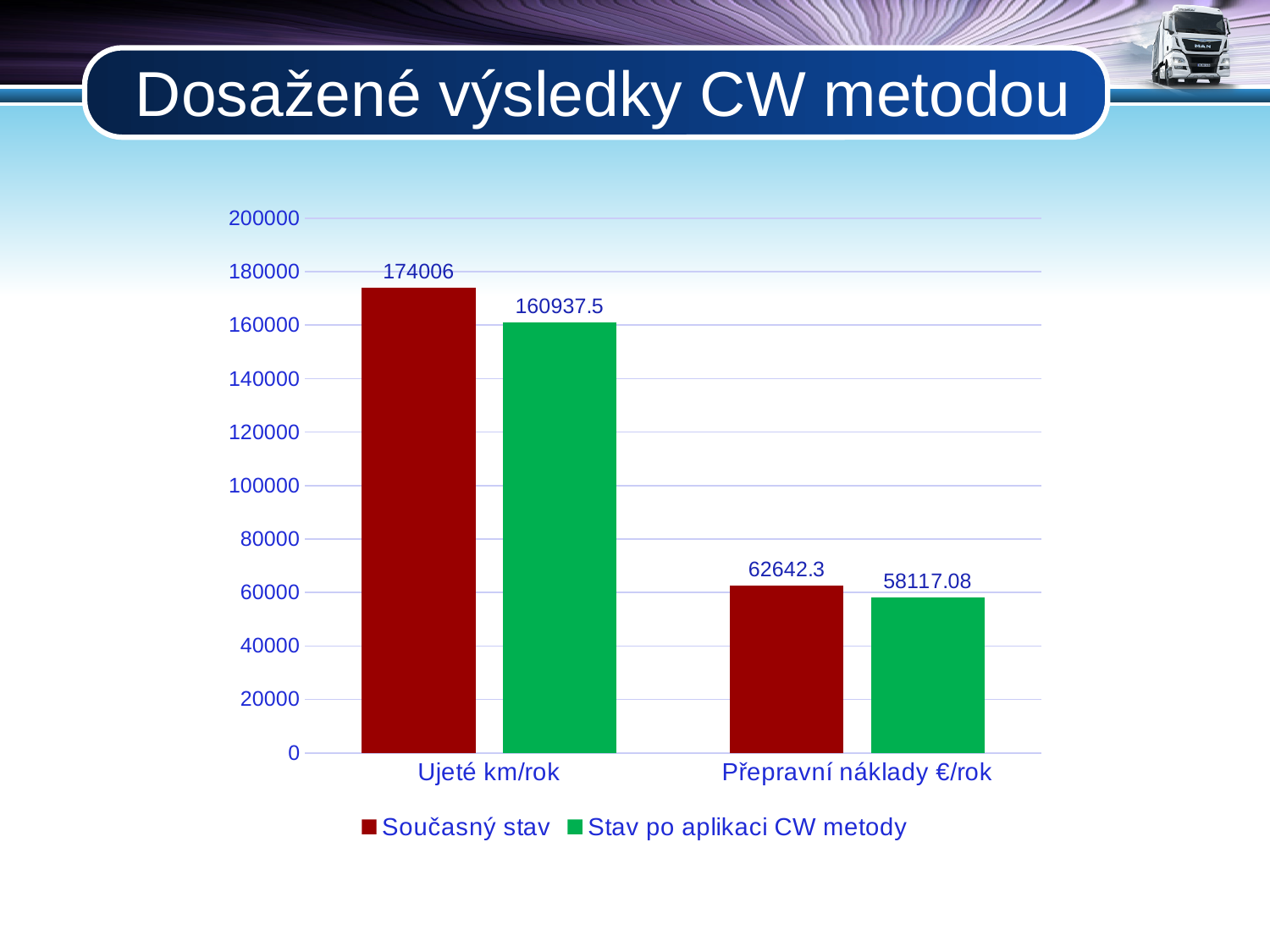
For Přepravní náklady €/rok, which is larger: Současný stav or Stav po aplikaci CW metody? Současný stav What is the difference between Současný stav and Stav po aplikaci CW metody for Ujeté km/rok? 13068.5 What is the difference between Současný stav and Stav po aplikaci CW metody for Přepravní náklady €/rok? 4525.22 What is the value of Současný stav for Přepravní náklady €/rok? 62642.3 What is the value of Současný stav for Ujeté km/rok? 174006 What is the value of Stav po aplikaci CW metody for Ujeté km/rok? 160937.5 What type of chart is shown on the slide? Bar chart What is the value of Stav po aplikaci CW metody for Přepravní náklady €/rok? 58117.08 Which bar has the highest value in the chart? Současný stav, Ujeté km/rok How many series does the legend list? 2 Which bar has the lowest value in the chart? Stav po aplikaci CW metody, Přepravní náklady €/rok How many categories are shown on the x axis? 2